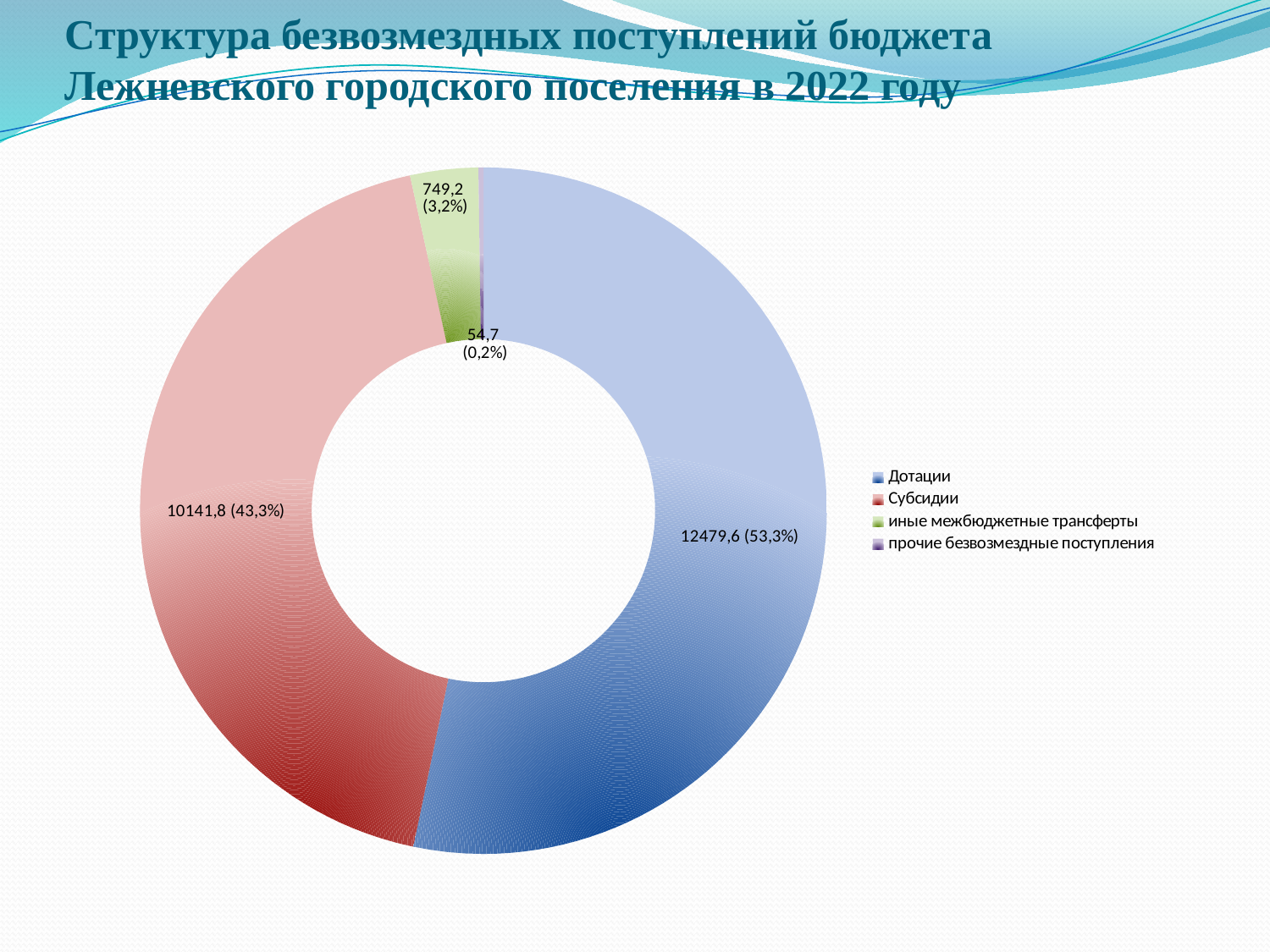
What colour represents Дотации in the chart? Blue What value is shown for Субсидии? 10141,8 (43,3%) What value is shown for Дотации? 12479,6 (53,3%) What is the difference between the values for Дотации and Субсидии? 2337,8 What kind of chart is shown on the slide? Doughnut (pie) chart What share of the chart does Субсидии represent? 43,3% What value is shown for иные межбюджетные трансферты? 749,2 (3,2%) What value is shown for прочие безвозмездные поступления? 54,7 (0,2%) Which category has the largest share of the chart? Дотации Which is larger, the value for Субсидии or the value for иные межбюджетные трансферты? Субсидии Which category has the smallest share of the chart? прочие безвозмездные поступления How many categories does the chart show? 4